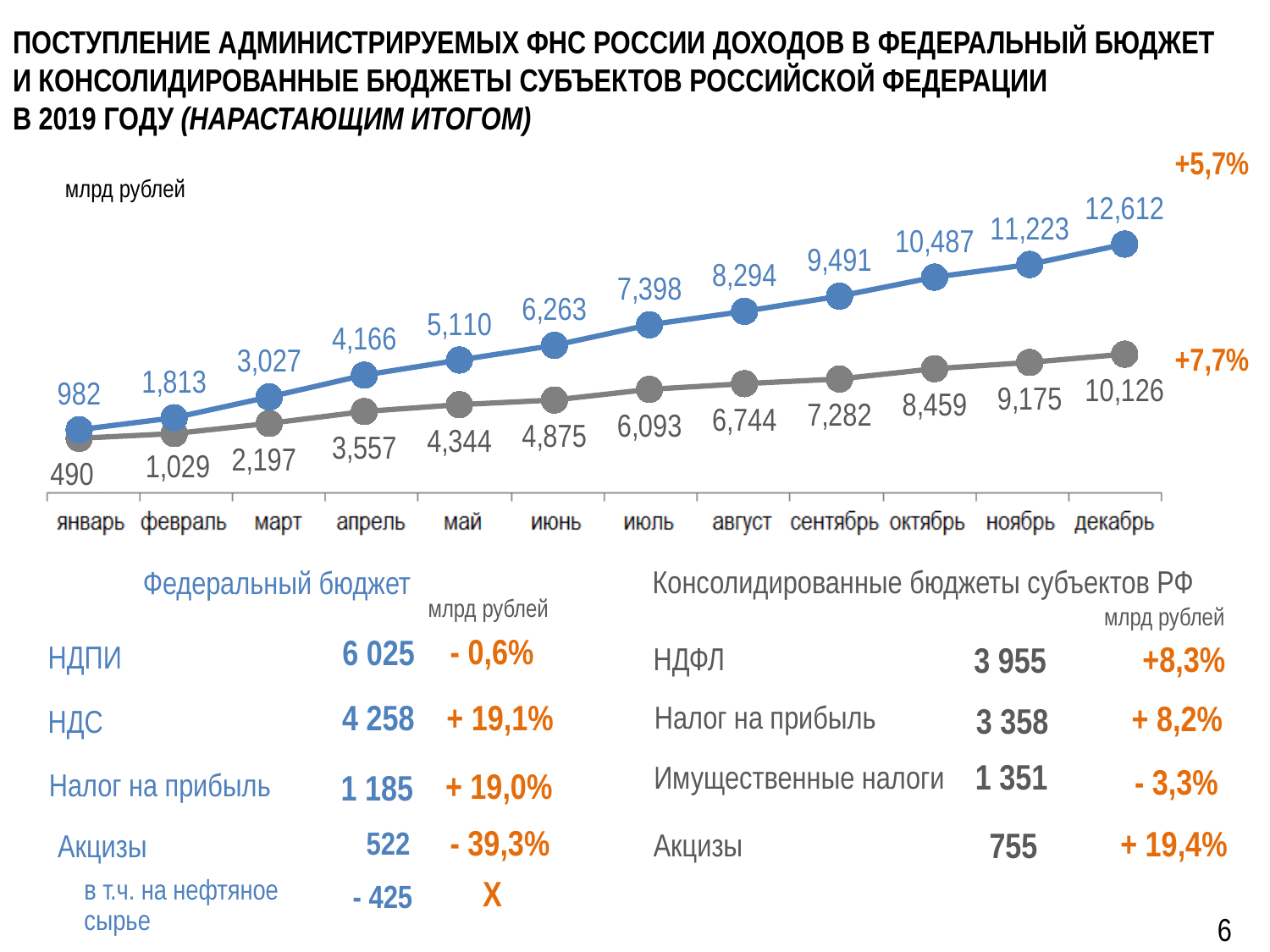
What is the value of the grey line (Консолидированные бюджеты субъектов РФ) for январь? 490 In which month does the grey line have its lowest value? январь In which month does the blue line reach its highest value? декабрь What type of chart is shown on the slide? line chart What is the value of the blue line for июнь? 6,263 What is the difference between the blue line and the grey line values for декабрь? 2,486 What is the value of the grey line for сентябрь? 7,282 How many months are plotted along the x axis of the chart? 12 How many data series are plotted on the chart? 2 What is the value of the blue line (Федеральный бюджет) for декабрь? 12,612 Do the values of the blue line rise or fall from январь to декабрь? rise Which line has the larger value for май, the blue line or the grey line? the blue line